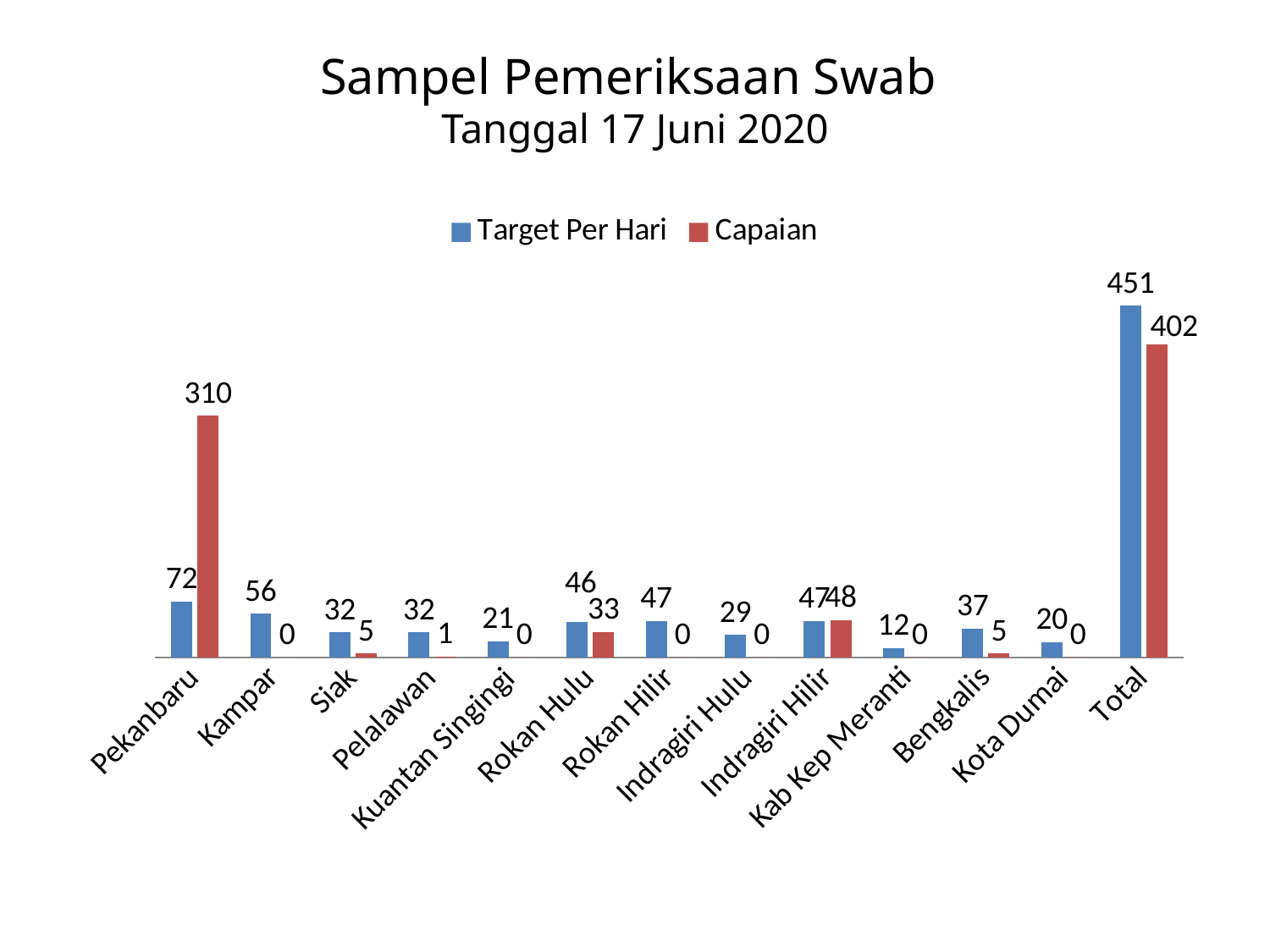
What is the Capaian value for Pekanbaru? 310 Excluding the Total bar, which category has the lowest Target Per Hari value? Kab Kep Meranti What is the Target Per Hari value for Kab Kep Meranti? 12 What kind of chart is shown on the slide? Bar chart Excluding the Total bar, which category has the highest Capaian value? Pekanbaru How many categories are shown on the x axis? 13 What is the Capaian value for Rokan Hulu? 33 How many series does the legend list? 2 What is the Target Per Hari value for Pekanbaru? 72 What is the difference between the Target Per Hari and Capaian values for Total? 49 Which is larger for Kampar, the Target Per Hari value or the Capaian value? Target Per Hari What is the title of the chart? Sampel Pemeriksaan Swab Tanggal 17 Juni 2020